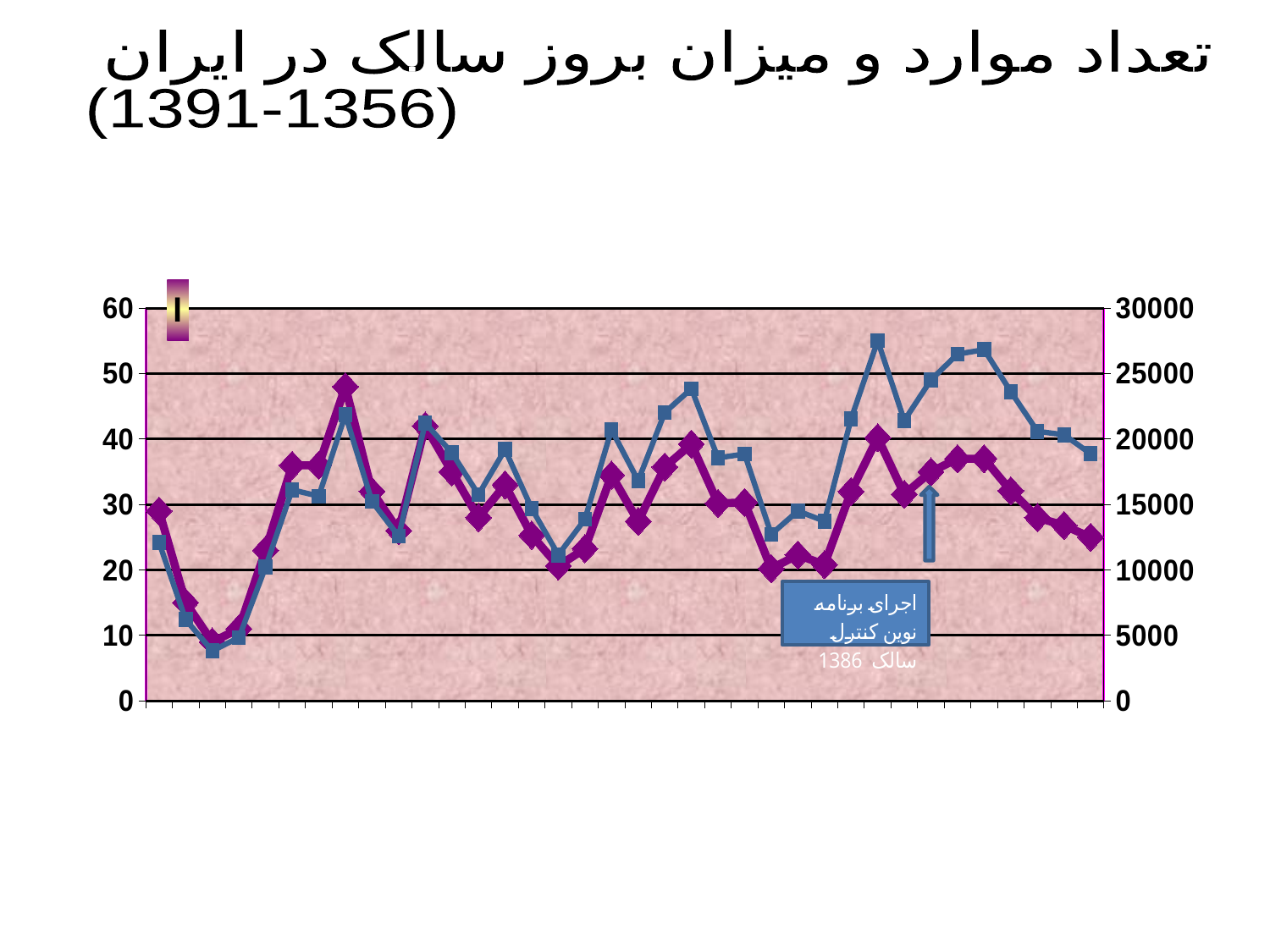
What is the highest value shown on the left vertical axis? 60 Is the peak of the purple diamond line greater or less than 40 on the left axis? greater Is the last point of the blue square line greater or less than 25000 on the right axis? less What is the highest value shown on the right vertical axis? 30000 Is the lowest point of the blue square line greater or less than 5000 on the right axis? less How many data series are plotted on the chart? 2 What kind of chart is shown on the slide? line chart